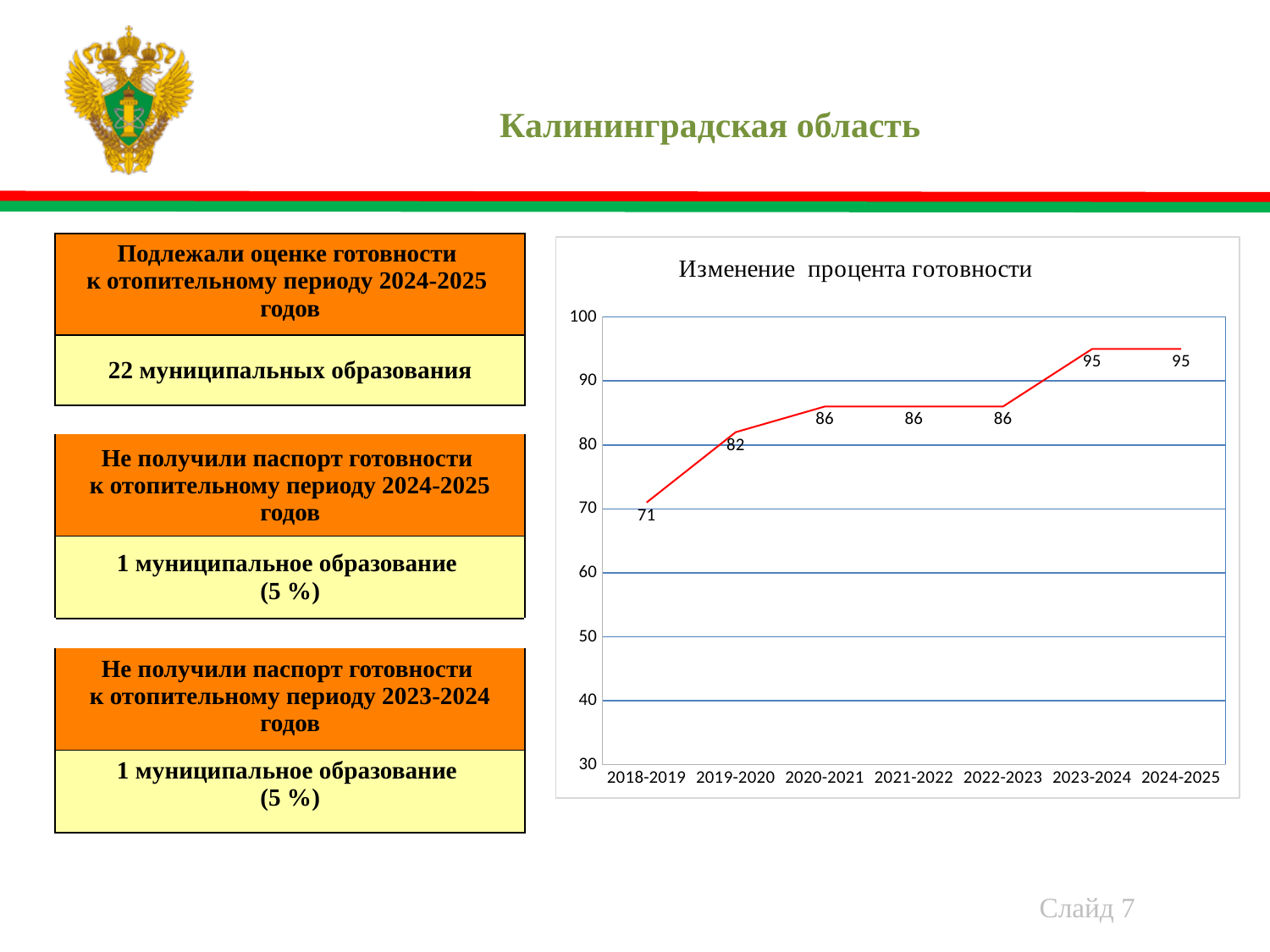
Which period has the lowest value in the chart? 2018-2019 Which is larger, the value for 2022-2023 or the value for 2023-2024? 2023-2024 What is the value for 2018-2019 in the chart 'Изменение процента готовности'? 71 What is the value for 2021-2022 in the chart? 86 What is the value for 2024-2025 in the chart? 95 How many periods are shown on the x axis of the chart? 7 What is the value for 2019-2020 in the chart? 82 What is the title of the chart on the slide? Изменение процента готовности What is the difference between the values for 2019-2020 and 2020-2021? 4 What kind of chart is shown on the slide? line chart What is the difference between the values for 2023-2024 and 2018-2019? 24 Is the value for 2018-2019 greater or less than 80? less